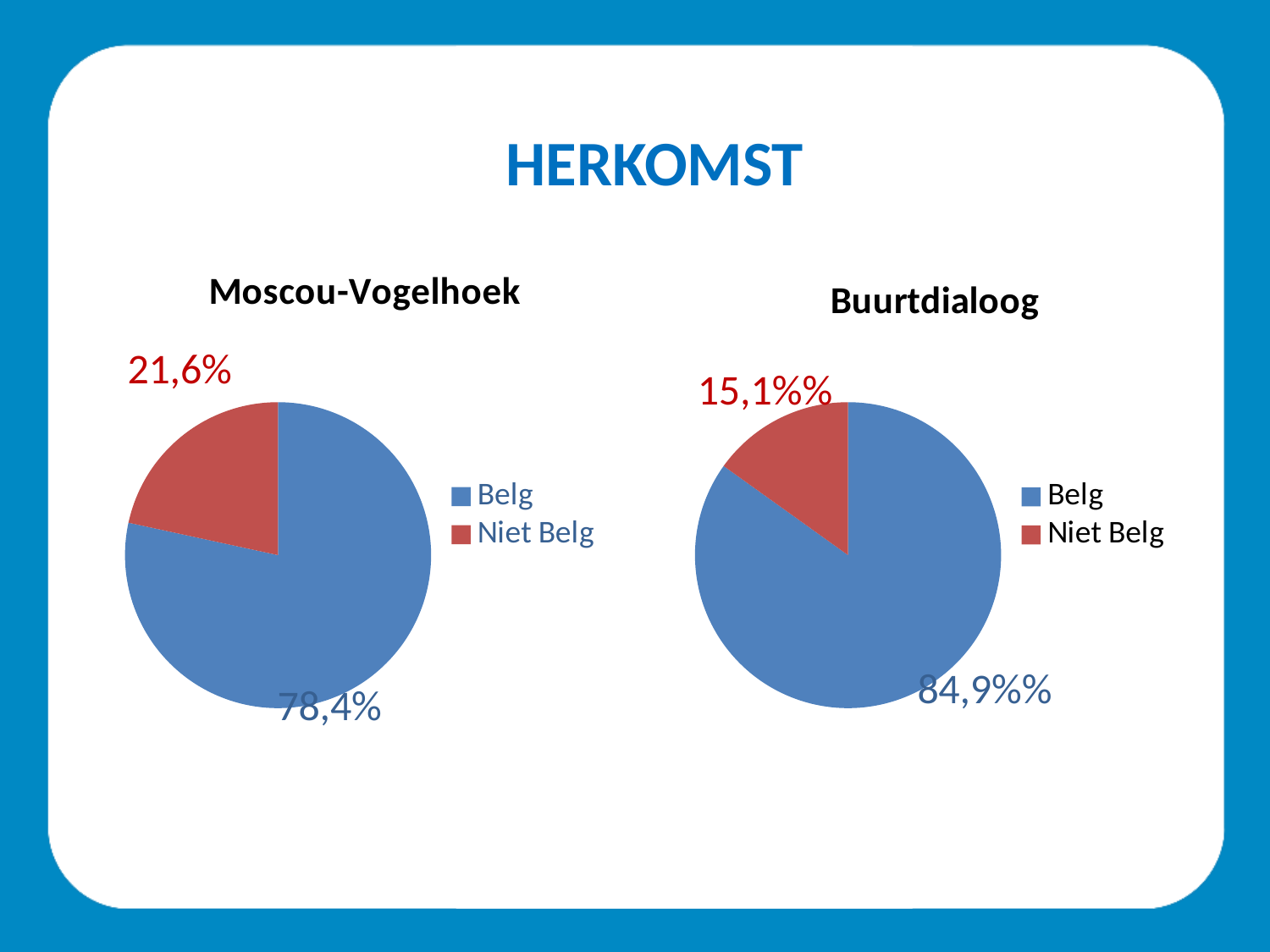
In the Moscou-Vogelhoek chart, which category has the largest slice? Belg In the Moscou-Vogelhoek chart, what percentage is shown for Belg? 78,4% What type of chart is used for Moscou-Vogelhoek? Pie chart In the Buurtdialoog chart, which category has the smallest slice? Niet Belg In the Moscou-Vogelhoek chart, what is the difference in percentage points between Belg and Niet Belg? 56,8 How many entries does the legend of the Moscou-Vogelhoek chart list? 2 In the Buurtdialoog chart, what value is printed for Belg? 84,9%% In the Moscou-Vogelhoek chart, what percentage is shown for Niet Belg? 21,6% Is the Belg share larger in the Moscou-Vogelhoek chart or in the Buurtdialoog chart? Buurtdialoog How many slices does the Buurtdialoog pie chart have? 2 In the Buurtdialoog chart, what value is printed for Niet Belg? 15,1%% In the Buurtdialoog chart, what colour is the Niet Belg slice? Red